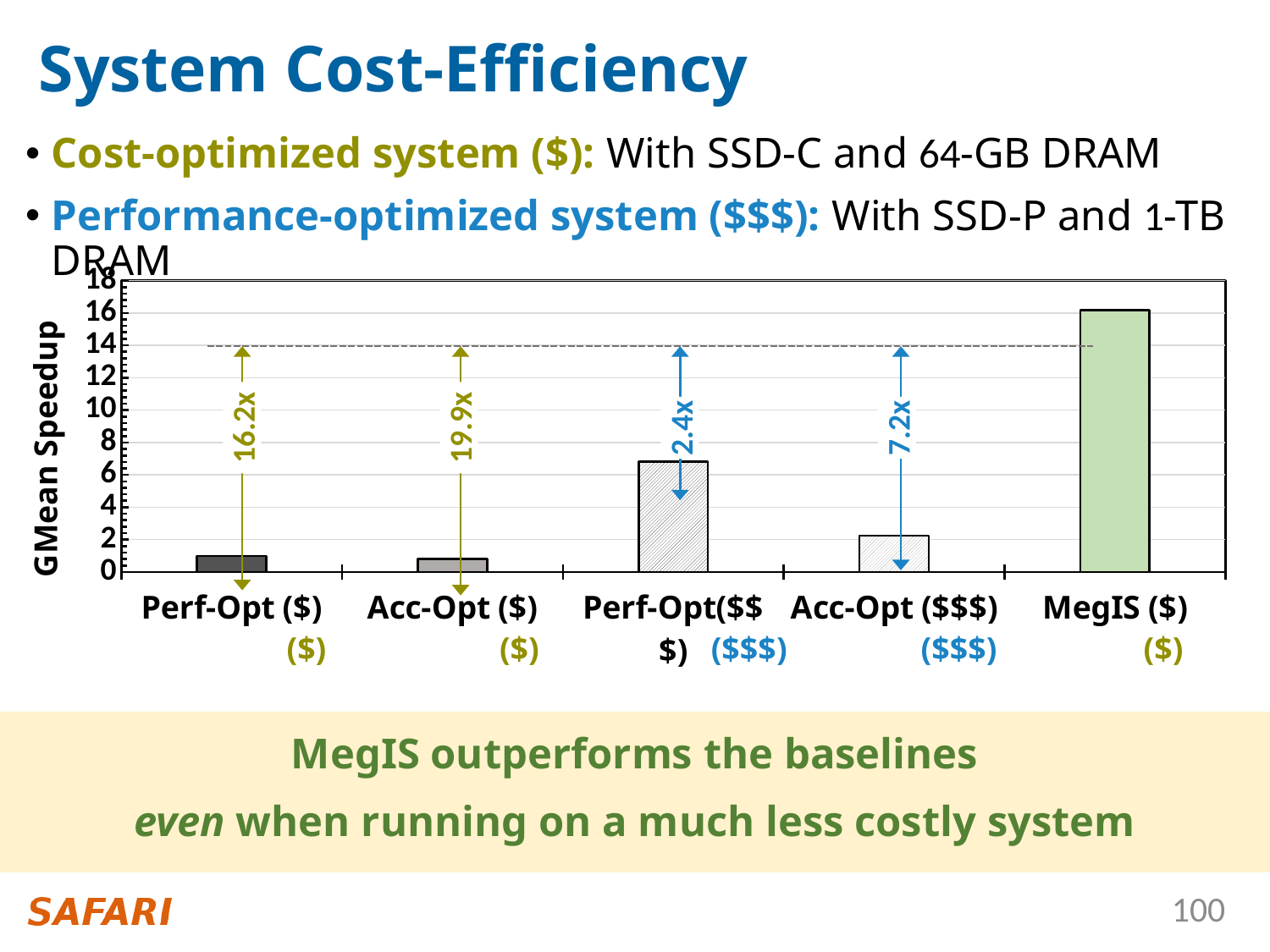
What kind of chart is shown on the slide? bar chart What speedup factor is annotated above the Perf-Opt ($) bar? 16.2x How many categories are shown on the x axis of the chart? 5 What speedup factor is annotated above the Acc-Opt ($$$) bar? 7.2x Which category has the highest GMean Speedup? MegIS ($) What speedup factor is annotated above the Acc-Opt ($) bar? 19.9x Is the GMean Speedup for Acc-Opt ($$$) greater or less than 4? less What speedup factor is annotated above the Perf-Opt($$$) bar? 2.4x Is the GMean Speedup for MegIS ($) greater or less than 14? greater Which has a higher GMean Speedup, Perf-Opt($$$) or Acc-Opt ($$$)? Perf-Opt($$$) Is the GMean Speedup for Perf-Opt($$$) greater or less than 8? less What is the label of the y axis? GMean Speedup